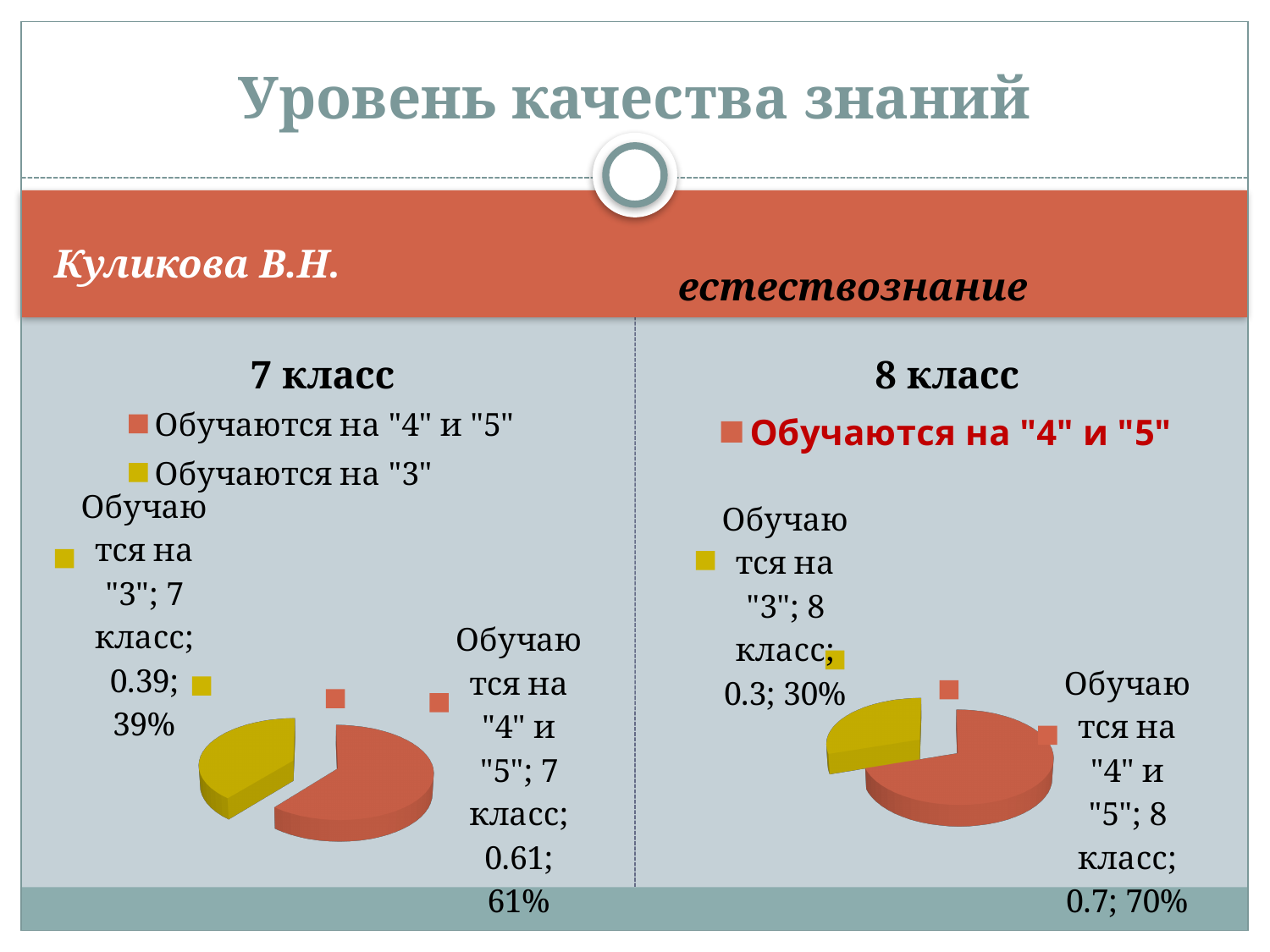
In the "8 класс" chart, what percentage is shown for "Обучаются на "4" и "5""? 70% In the "8 класс" chart, which slice is the smallest? Обучаются на "3" In the "8 класс" chart, what is the difference in percentage points between "Обучаются на "4" и "5"" and "Обучаются на "3""? 40 In the "8 класс" chart, what percentage is shown for "Обучаются на "3""? 30% In the "7 класс" chart, what percentage is shown for "Обучаются на "4" и "5""? 61% In the "7 класс" chart, what percentage is shown for "Обучаются на "3""? 39% What type of chart is the "7 класс" chart? pie chart In the "7 класс" chart, which slice is the largest? Обучаются на "4" и "5" How many slices does the "8 класс" pie chart have? 2 Which chart shows a larger share for "Обучаются на "4" и "5"", "7 класс" or "8 класс"? 8 класс In the "7 класс" chart, what is the difference in percentage points between "Обучаются на "4" и "5"" and "Обучаются на "3""? 22 What colour is the "Обучаются на "3"" slice in the "7 класс" chart? yellow